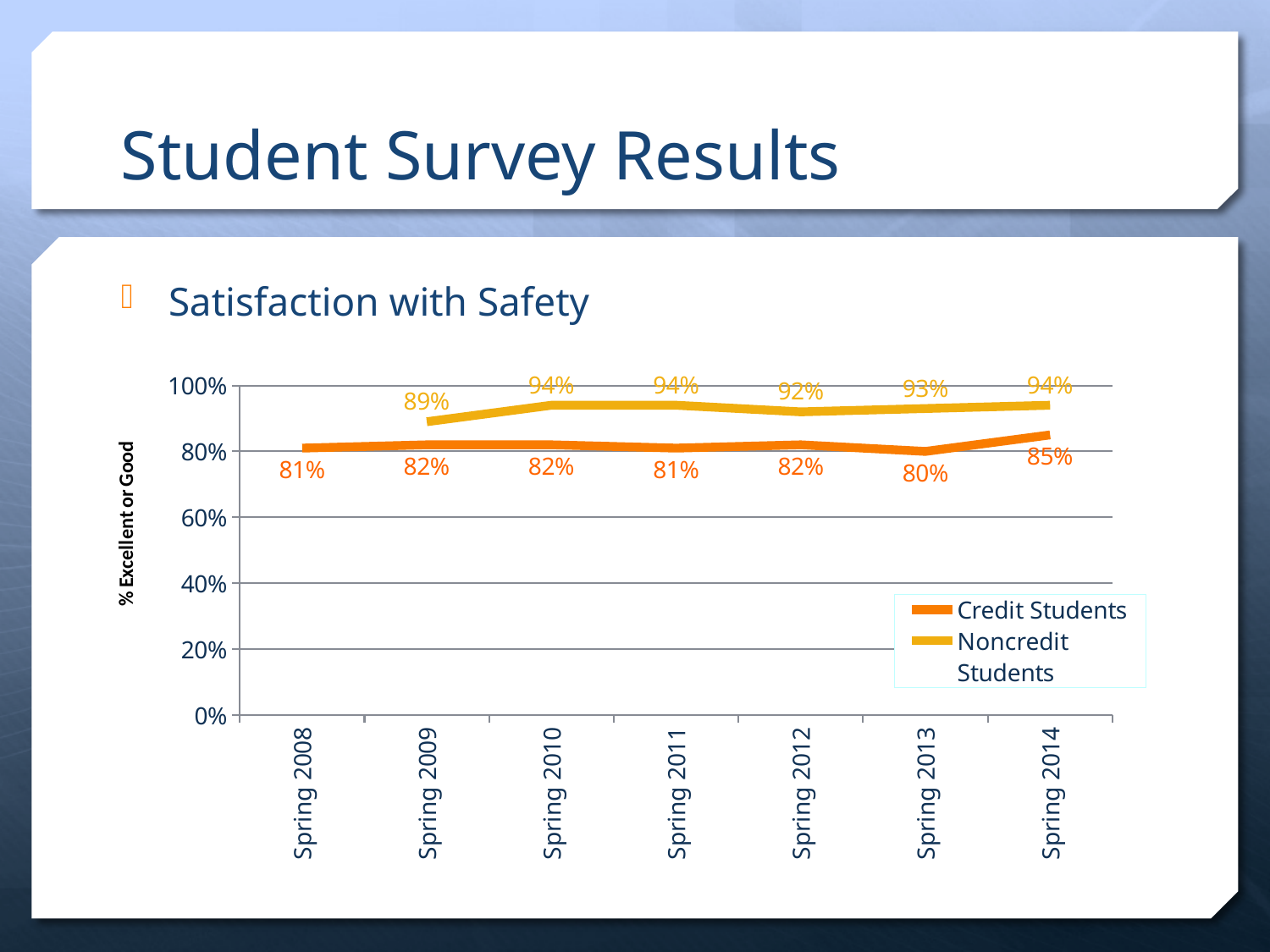
How many series does the legend list? 2 What is the label of the y axis? % Excellent or Good In which year is the Credit Students value highest? Spring 2014 What is the value for Credit Students in Spring 2013? 80% What kind of chart is shown on the slide? Line chart How many time points are shown on the x axis? 7 What is the value for Noncredit Students in Spring 2012? 92% What is the value for Noncredit Students in Spring 2009? 89% Which series has the larger value in Spring 2011, Credit Students or Noncredit Students? Noncredit Students What is the difference between Noncredit Students and Credit Students in Spring 2010? 12% In which year is the Credit Students value lowest? Spring 2013 What is the value for Credit Students in Spring 2014? 85%